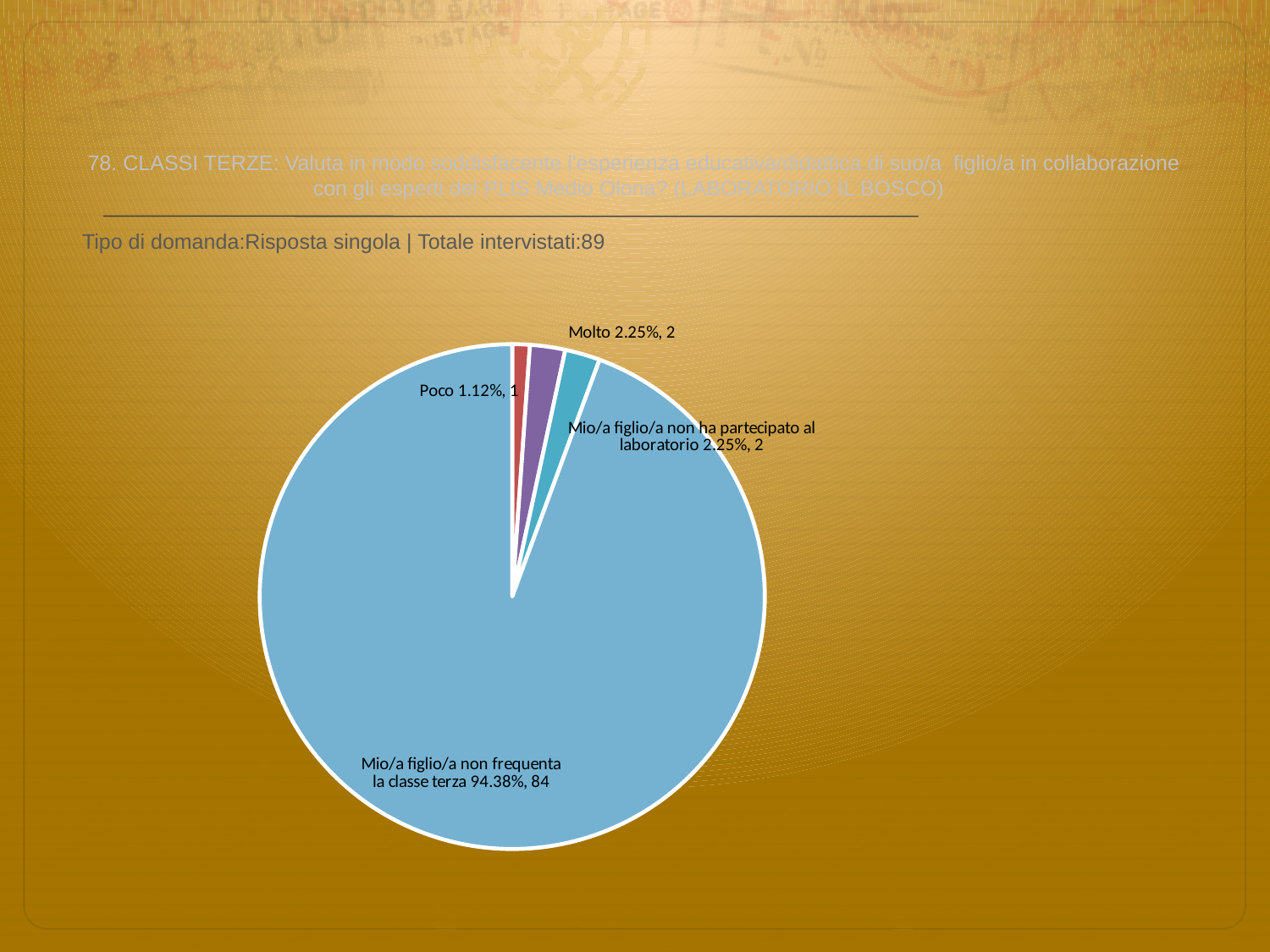
What percentage share does the slice 'Poco' have? 1.12% What is the difference in respondent count between 'Mio/a figlio/a non frequenta la classe terza' and 'Molto'? 82 What percentage share does the slice 'Mio/a figlio/a non frequenta la classe terza' have? 94.38% How many respondents are counted in the slice 'Mio/a figlio/a non ha partecipato al laboratorio'? 2 Which slice is the largest in the pie chart? Mio/a figlio/a non frequenta la classe terza Which slice is the smallest in the pie chart? Poco How many respondents are counted in the slice 'Poco'? 1 What kind of chart is shown on the slide? pie chart How many respondents are counted in the slice 'Mio/a figlio/a non frequenta la classe terza'? 84 Which slice is larger, 'Molto' or 'Poco'? Molto How many slices does the pie chart have? 4 What percentage share does the slice 'Molto' have? 2.25%